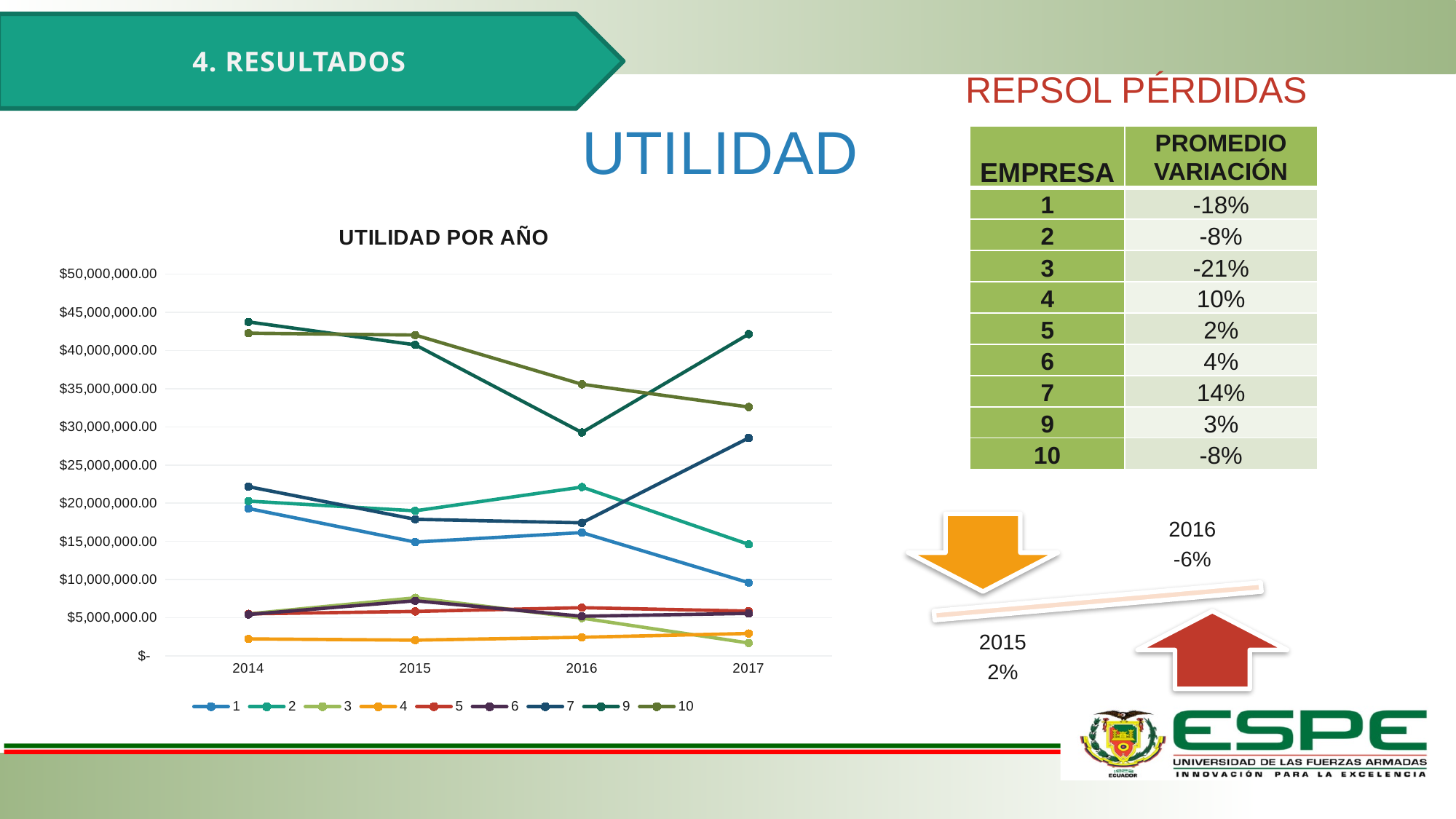
In the "UTILIDAD POR AÑO" chart, which series has the higher value in 2017, series 7 or series 2? 7 In the "UTILIDAD POR AÑO" chart, is the value for series 10 in 2017 greater or less than $30,000,000.00? greater How many series does the legend of the "UTILIDAD POR AÑO" chart list? 9 In the "UTILIDAD POR AÑO" chart, which series has the highest value in 2017? 9 In the "UTILIDAD POR AÑO" chart, does the value for series 10 rise or fall from 2014 to 2017? fall In the "UTILIDAD POR AÑO" chart, which series has the lowest value in 2017? 3 What kind of chart is "UTILIDAD POR AÑO"? line chart What is the title of the line chart on the slide? UTILIDAD POR AÑO In the "UTILIDAD POR AÑO" chart, is the value for series 2 in 2016 greater or less than $20,000,000.00? greater In the "UTILIDAD POR AÑO" chart, is the value for series 4 in 2014 greater or less than $5,000,000.00? less How many years are shown on the x axis of the "UTILIDAD POR AÑO" chart? 4